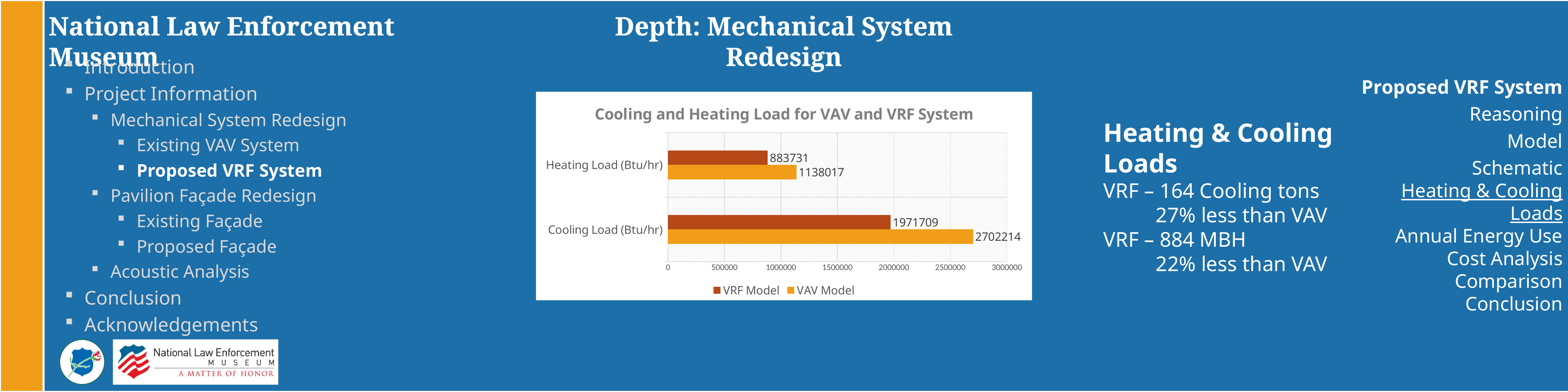
How many series does the legend list? 2 What is the VAV Model value for Cooling Load (Btu/hr)? 2702214 Which series has the higher Cooling Load (Btu/hr), VRF Model or VAV Model? VAV Model Which bar in the chart is the smallest? VRF Model, Heating Load (Btu/hr) What is the VRF Model value for Heating Load (Btu/hr)? 883731 How many categories are shown on the chart? 2 Which bar in the chart is the largest? VAV Model, Cooling Load (Btu/hr) What is the VAV Model value for Heating Load (Btu/hr)? 1138017 What is the VRF Model value for Cooling Load (Btu/hr)? 1971709 What is the difference between the VAV Model and VRF Model values for Heating Load (Btu/hr)? 254286 What type of chart is shown on the slide? Bar chart What is the difference between the VAV Model and VRF Model values for Cooling Load (Btu/hr)? 730505